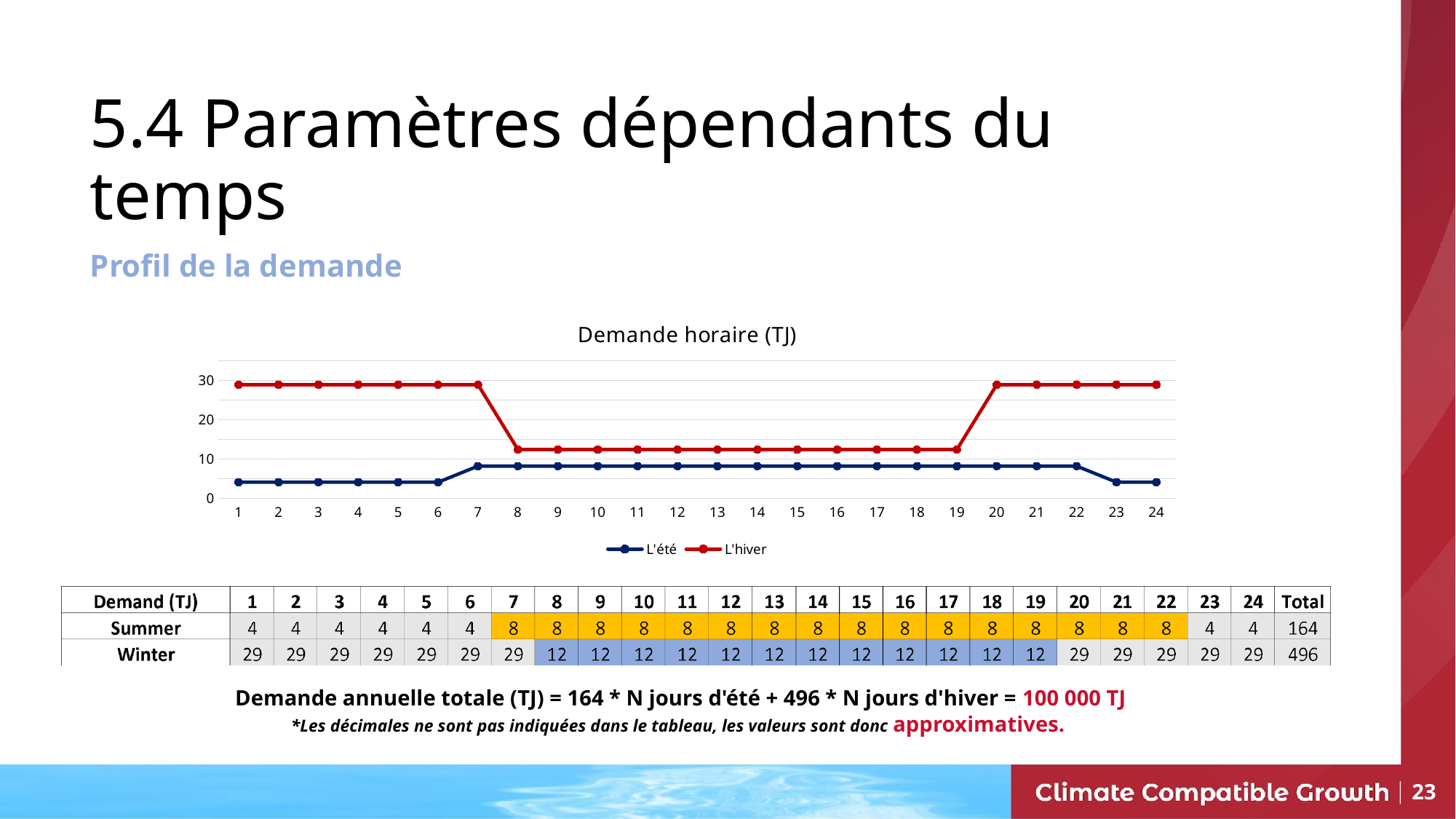
Is the value for L'hiver at hour 1 greater or less than 20? greater How many series does the legend of the chart list? 2 What kind of chart is shown on the slide? line chart At hour 10, which series has the higher value, L'été or L'hiver? L'hiver Which series is drawn in red in the chart? L'hiver How many hours (points) are plotted along the x axis of the chart? 24 What is the title of the chart? Demande horaire (TJ) Is the value for L'hiver at hour 12 greater or less than 20? less Does the L'hiver line rise or fall between hour 7 and hour 8? fall Does the L'été line rise or fall between hour 6 and hour 7? rise Is the value for L'été at hour 3 greater or less than 10? less